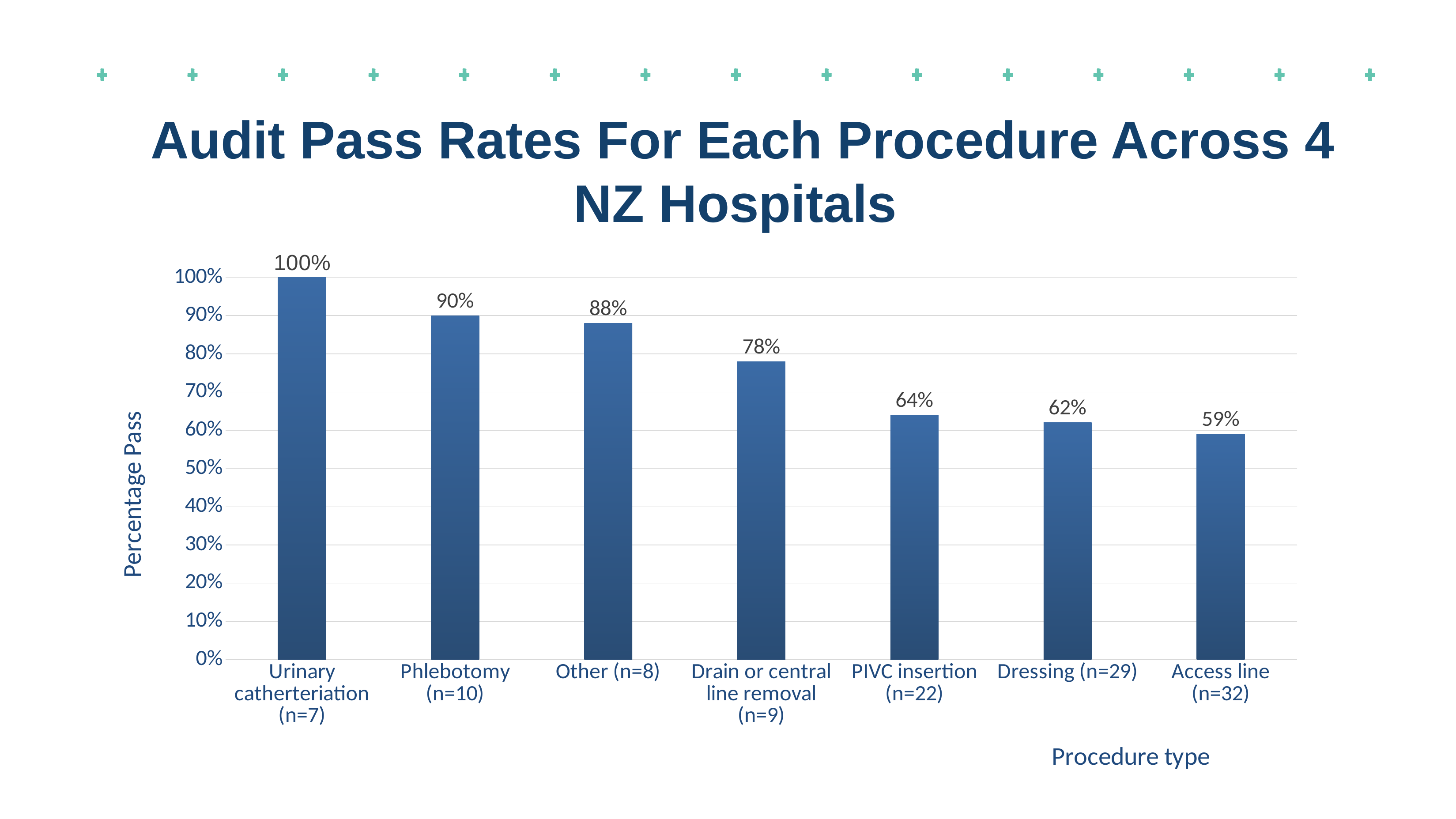
Which procedure type has the highest audit pass rate? Urinary catherteriation (n=7) What is the label of the vertical axis? Percentage Pass How many procedure types are shown on the chart? 7 What is the audit pass rate for Access line (n=32)? 59% What is the audit pass rate for Drain or central line removal (n=9)? 78% Do the pass rates rise or fall from left to right across the procedure types? fall What kind of chart is shown on the slide? bar chart Which procedure type has the lowest audit pass rate? Access line (n=32) Which has a higher pass rate, Dressing (n=29) or Drain or central line removal (n=9)? Drain or central line removal (n=9) What is the audit pass rate for Phlebotomy (n=10)? 90% What is the difference in pass rate between Other (n=8) and PIVC insertion (n=22)? 24% Is the pass rate for PIVC insertion (n=22) greater or less than 70%? less